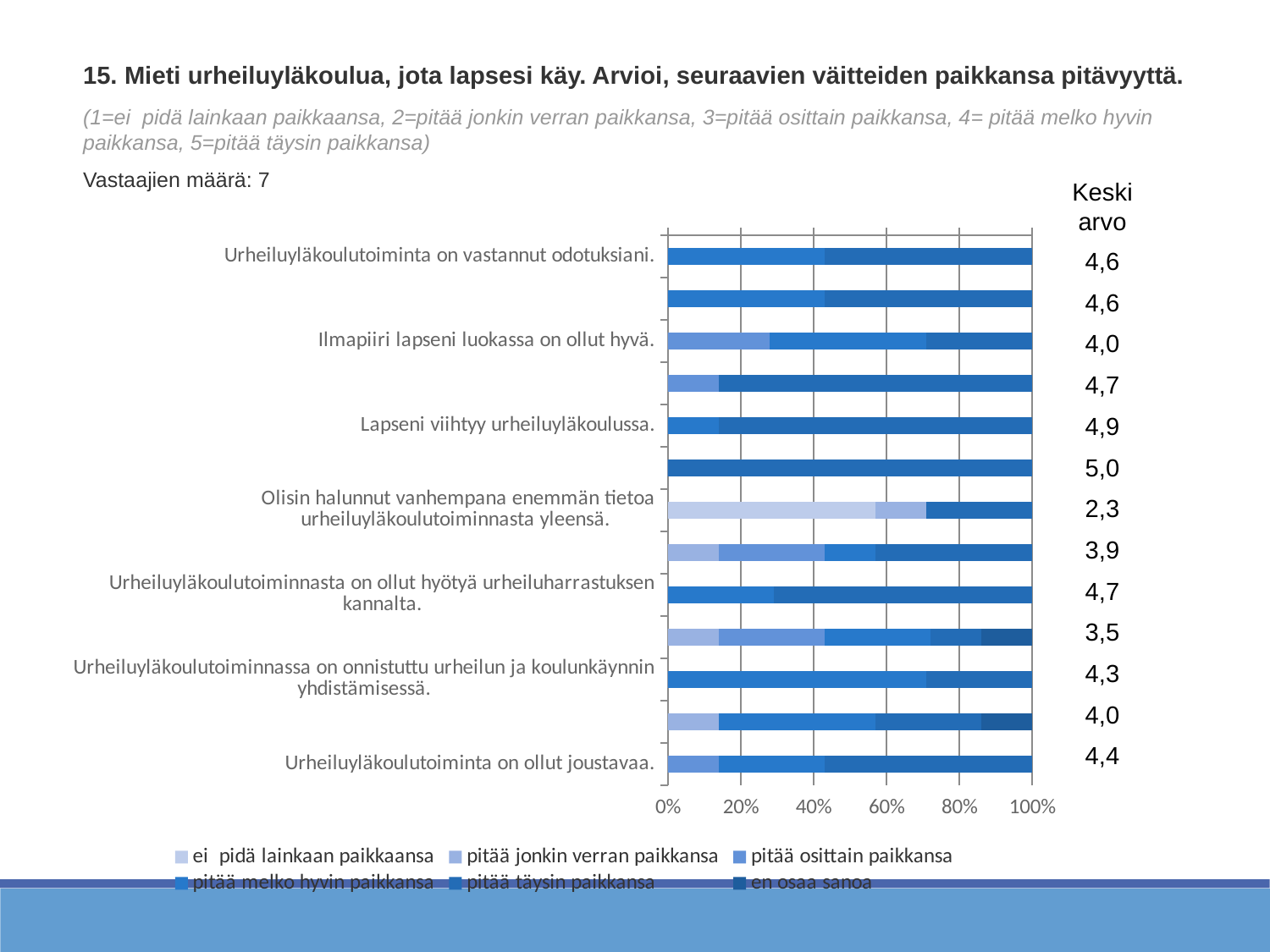
What is the difference between the Keskiarvo values for 'Lapseni viihtyy urheiluyläkoulussa.' (4,9) and 'Olisin halunnut vanhempana enemmän tietoa urheiluyläkoulutoiminnasta yleensä.' (2,3)? 2,6 Is the 'ei pidä lainkaan paikkaansa' share for 'Olisin halunnut vanhempana enemmän tietoa urheiluyläkoulutoiminnasta yleensä.' greater or less than 40%? greater What is the highest Keskiarvo (mean) value printed on the slide? 5,0 What is the Keskiarvo (mean) value for 'Lapseni viihtyy urheiluyläkoulussa.'? 4,9 How many bars are plotted in the chart? 13 What kind of chart is shown on the slide? Stacked bar chart What is the Keskiarvo (mean) value for 'Urheiluyläkoulutoiminta on vastannut odotuksiani.'? 4,6 Which labelled statement has the lowest Keskiarvo (mean) value? Olisin halunnut vanhempana enemmän tietoa urheiluyläkoulutoiminnasta yleensä. What is the Keskiarvo (mean) value for 'Olisin halunnut vanhempana enemmän tietoa urheiluyläkoulutoiminnasta yleensä.'? 2,3 How many entries does the chart legend list? 6 Which has the higher Keskiarvo value: 'Ilmapiiri lapseni luokassa on ollut hyvä.' or 'Urheiluyläkoulutoiminta on ollut joustavaa.'? Urheiluyläkoulutoiminta on ollut joustavaa. What is the Keskiarvo (mean) value for 'Urheiluyläkoulutoiminta on ollut joustavaa.'? 4,4